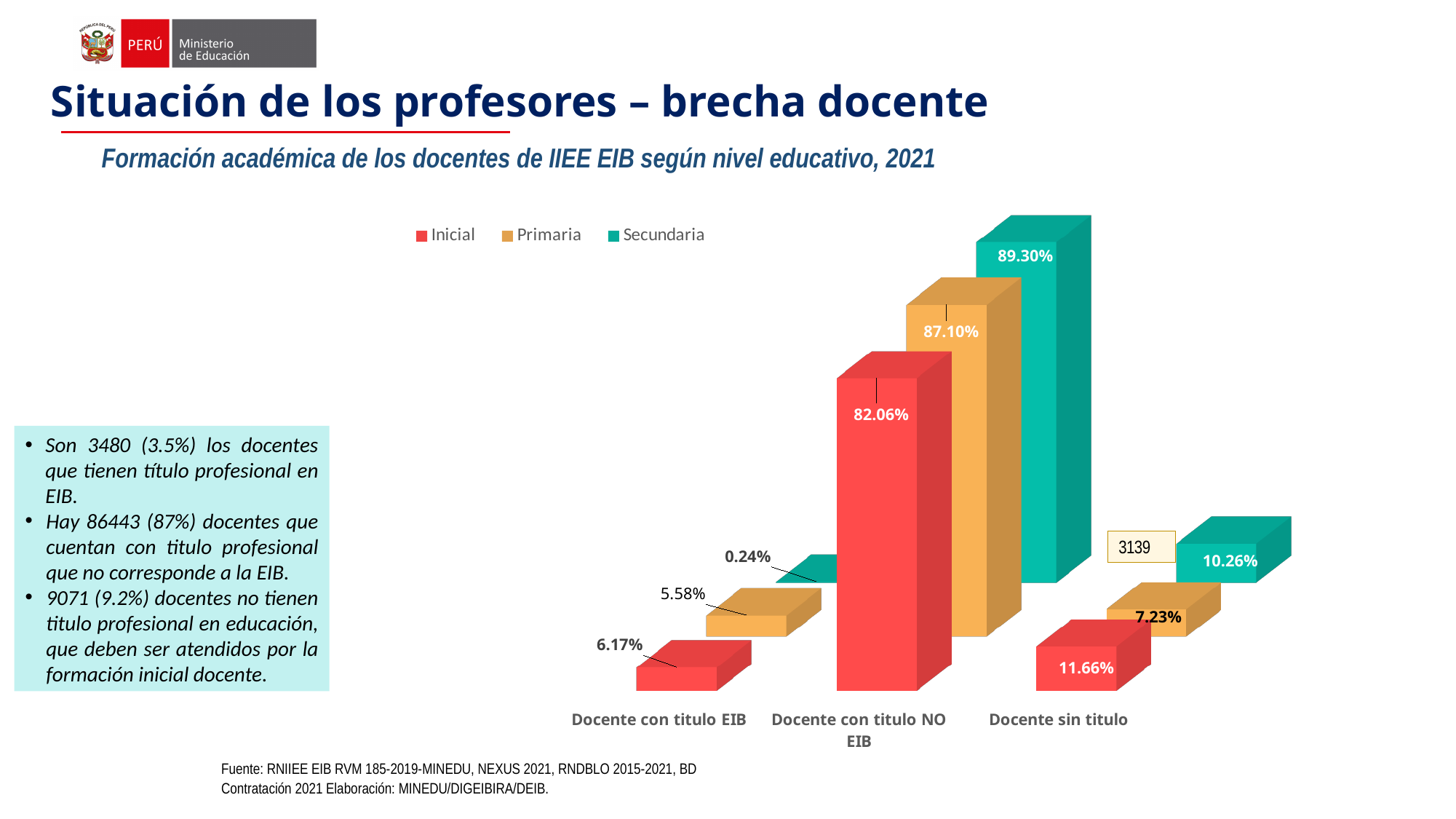
How many series does the legend list? 3 What kind of chart is shown on the slide? bar chart Which series has the lowest value in the 'Docente con titulo EIB' category? Secundaria What is the value for Secundaria in the 'Docente con titulo NO EIB' category? 89.30% Which series has the highest value in the 'Docente con titulo NO EIB' category? Secundaria What is the value for Inicial in the 'Docente con titulo EIB' category? 6.17% What is the value for Secundaria in the 'Docente con titulo EIB' category? 0.24% In the 'Docente sin titulo' category, which is larger: Inicial or Secundaria? Inicial Which series is shown in red in the legend? Inicial How many categories are shown on the x axis? 3 What is the value for Primaria in the 'Docente sin titulo' category? 7.23% What is the difference between the Secundaria and Inicial values in the 'Docente con titulo NO EIB' category? 7.24%